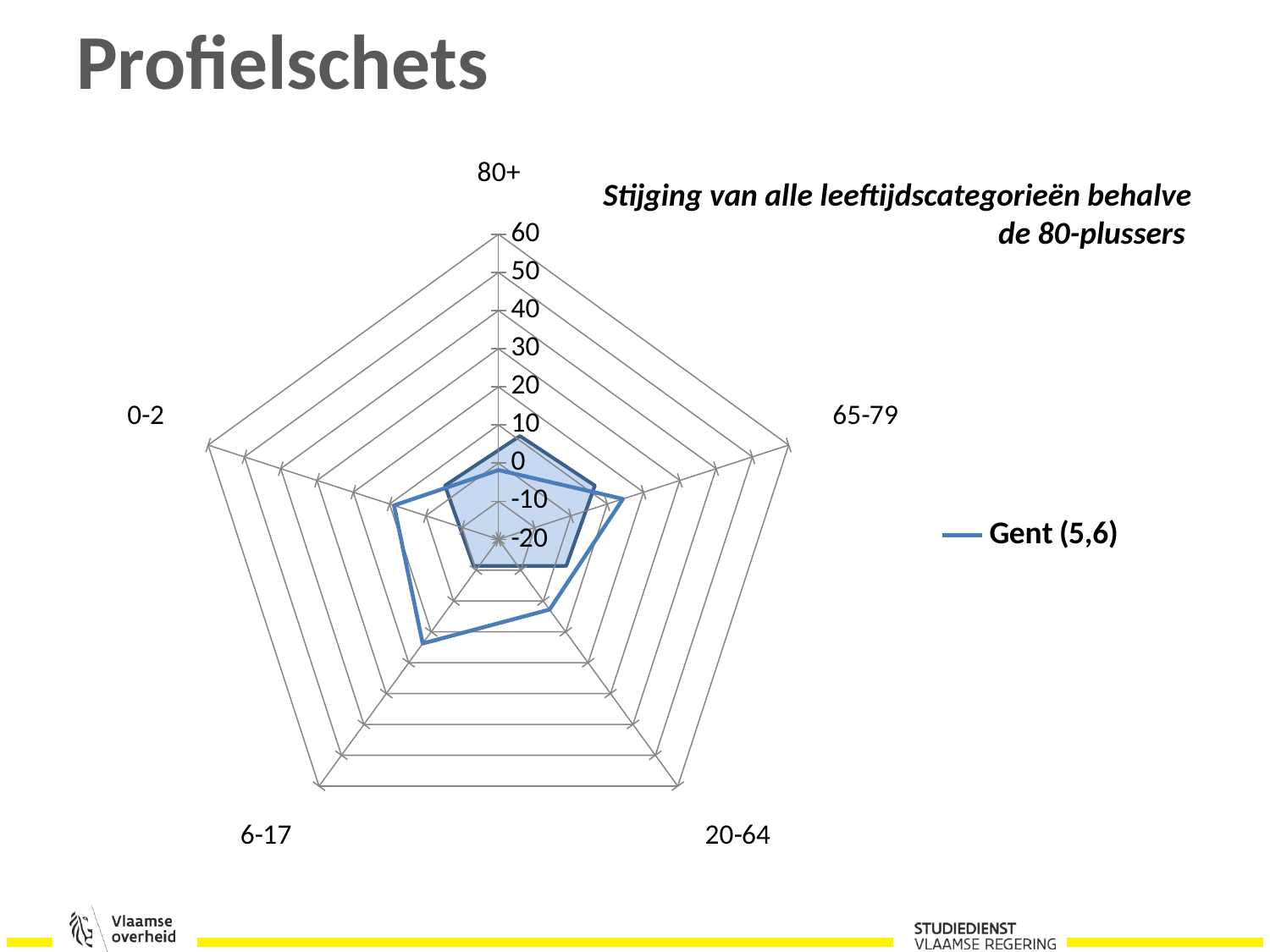
Is the value for the 80+ category greater or less than 0? less How many age categories are plotted on the radar chart? 5 What is the legend entry of the series plotted on the radar chart? Gent (5,6) Which age category has the lowest value on the radar chart? 80+ Is the value for the 6-17 category greater or less than 10? greater How many series does the legend of the radar chart list? 1 What is the highest value shown on the radar chart's axis scale? 60 Is the value for the 65-79 category greater or less than 0? greater What kind of chart is shown on the slide? radar chart Which has the larger value, the 6-17 category or the 80+ category? 6-17